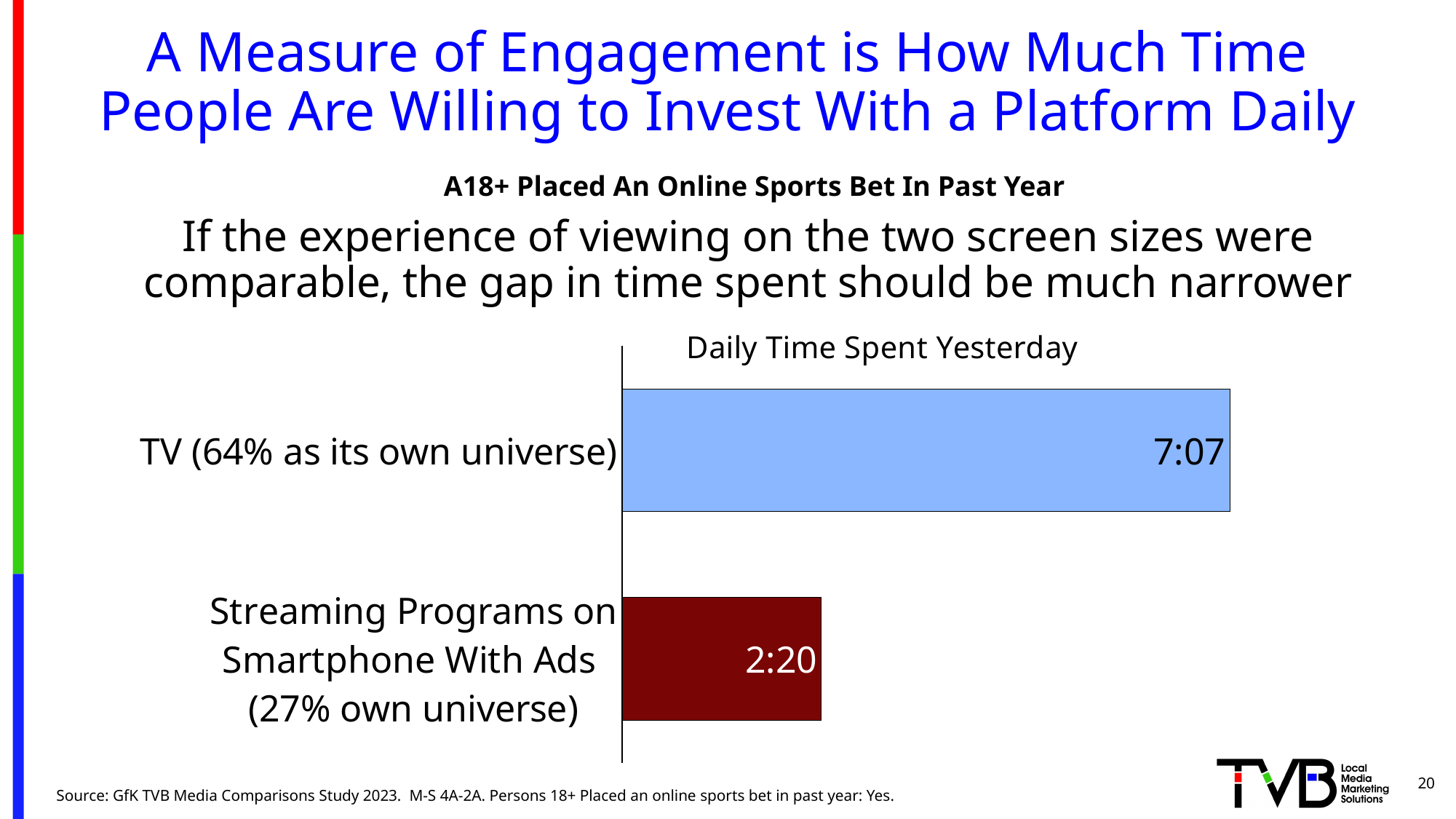
How many categories are shown in the chart? 2 Which category has the highest daily time spent yesterday? TV (64% as its own universe) What is the daily time spent yesterday for TV (64% as its own universe)? 7:07 What is the daily time spent yesterday for Streaming Programs on Smartphone With Ads (27% own universe)? 2:20 What colour is the bar for Streaming Programs on Smartphone With Ads? Dark red Which category has the lowest daily time spent yesterday? Streaming Programs on Smartphone With Ads (27% own universe) What is the title of the chart? Daily Time Spent Yesterday Which has a larger daily time spent yesterday: TV or Streaming Programs on Smartphone With Ads? TV What is the difference in daily time spent yesterday between TV and Streaming Programs on Smartphone With Ads? 4:47 What kind of chart is shown on the slide? Bar chart